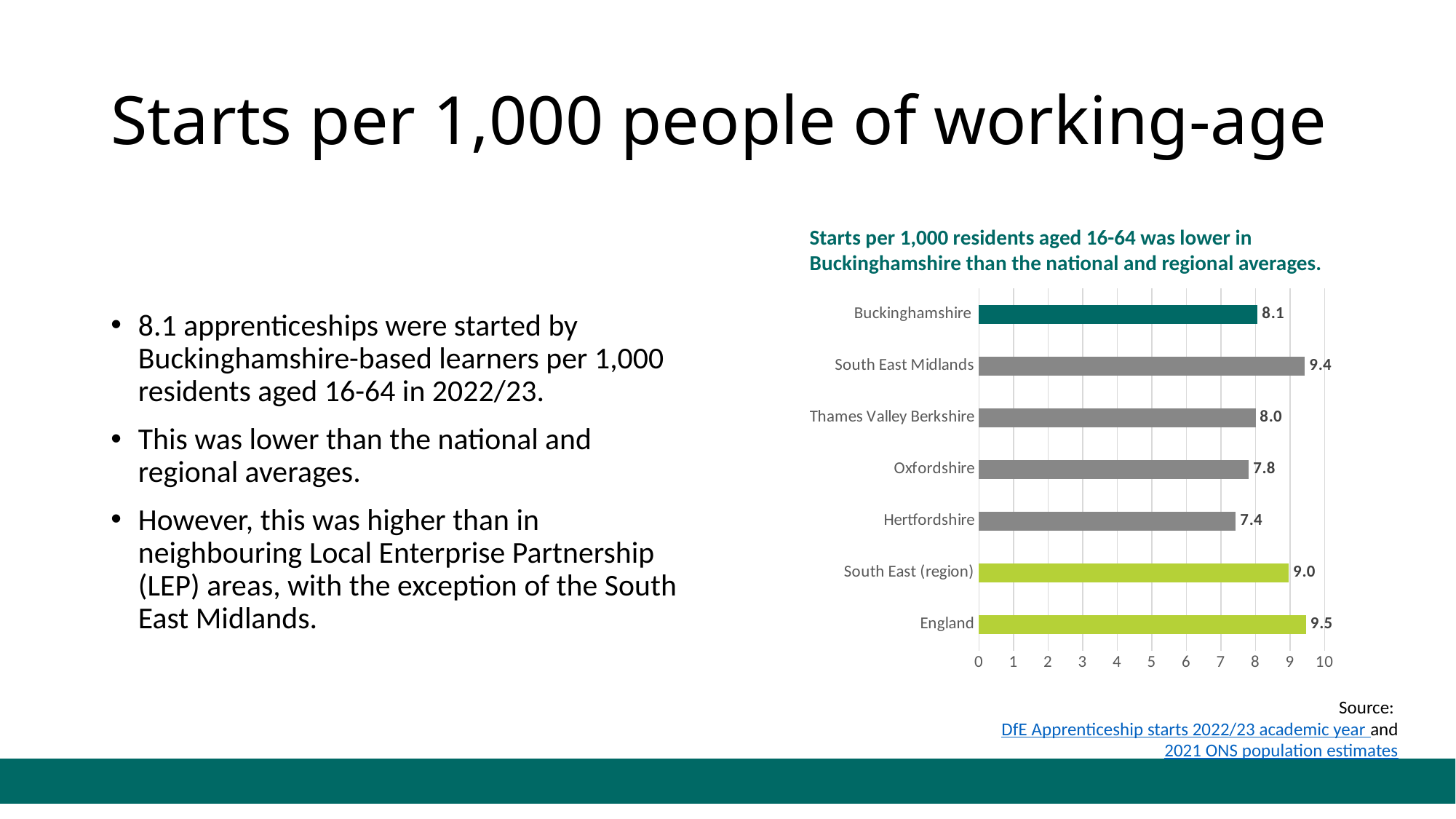
Is the value for South East (region) greater or less than 8? greater What is the value for England? 9.5 What is the value for South East Midlands? 9.4 What is the title of the chart? Starts per 1,000 residents aged 16-64 was lower in Buckinghamshire than the national and regional averages. Which category has the highest value? England How many categories are shown in the chart? 7 What is the value for Hertfordshire? 7.4 What is the difference between the values for England and Buckinghamshire? 1.4 What kind of chart is shown on the slide? bar chart What is the value for Buckinghamshire? 8.1 Which is larger, the value for Oxfordshire or the value for Thames Valley Berkshire? Thames Valley Berkshire Which category has the lowest value? Hertfordshire